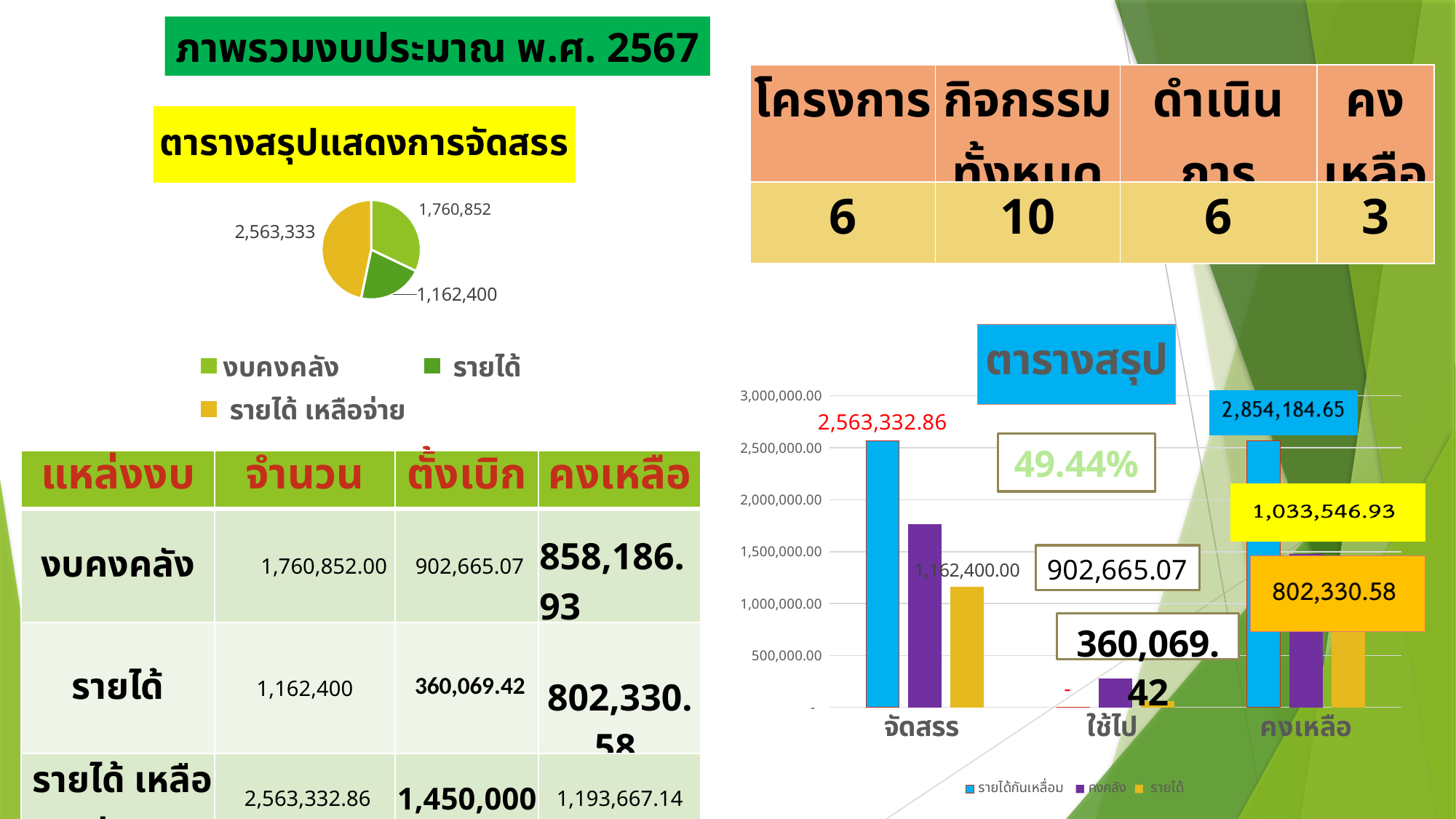
In the pie chart on the left, which category has the largest slice? รายได้ เหลือจ่าย In the ตารางสรุป bar chart on the right, which series has the tallest bar in the จัดสรร category? รายได้กันเหลื่อม In the ตารางสรุป bar chart on the right, how many categories are shown on the x axis? 3 In the pie chart on the left, what is the value of the รายได้ เหลือจ่าย slice? 2,563,333 In the pie chart on the left, what is the value of the งบคงคลัง slice? 1,760,852 How many entries does the legend of the pie chart on the left list? 3 In the pie chart on the left, which category has the smallest slice? รายได้ In the pie chart on the left, what is the value of the รายได้ slice? 1,162,400 What type of chart is the ตารางสรุป chart on the right? bar chart In the pie chart on the left, what is the difference between the รายได้ เหลือจ่าย slice and the งบคงคลัง slice? 802,481 What type of chart is the chart on the left under the heading ตารางสรุปแสดงการจัดสรร? pie chart In the ตารางสรุป bar chart on the right, is the value of the คงคลัง bar for จัดสรร greater or less than 1,500,000.00? greater